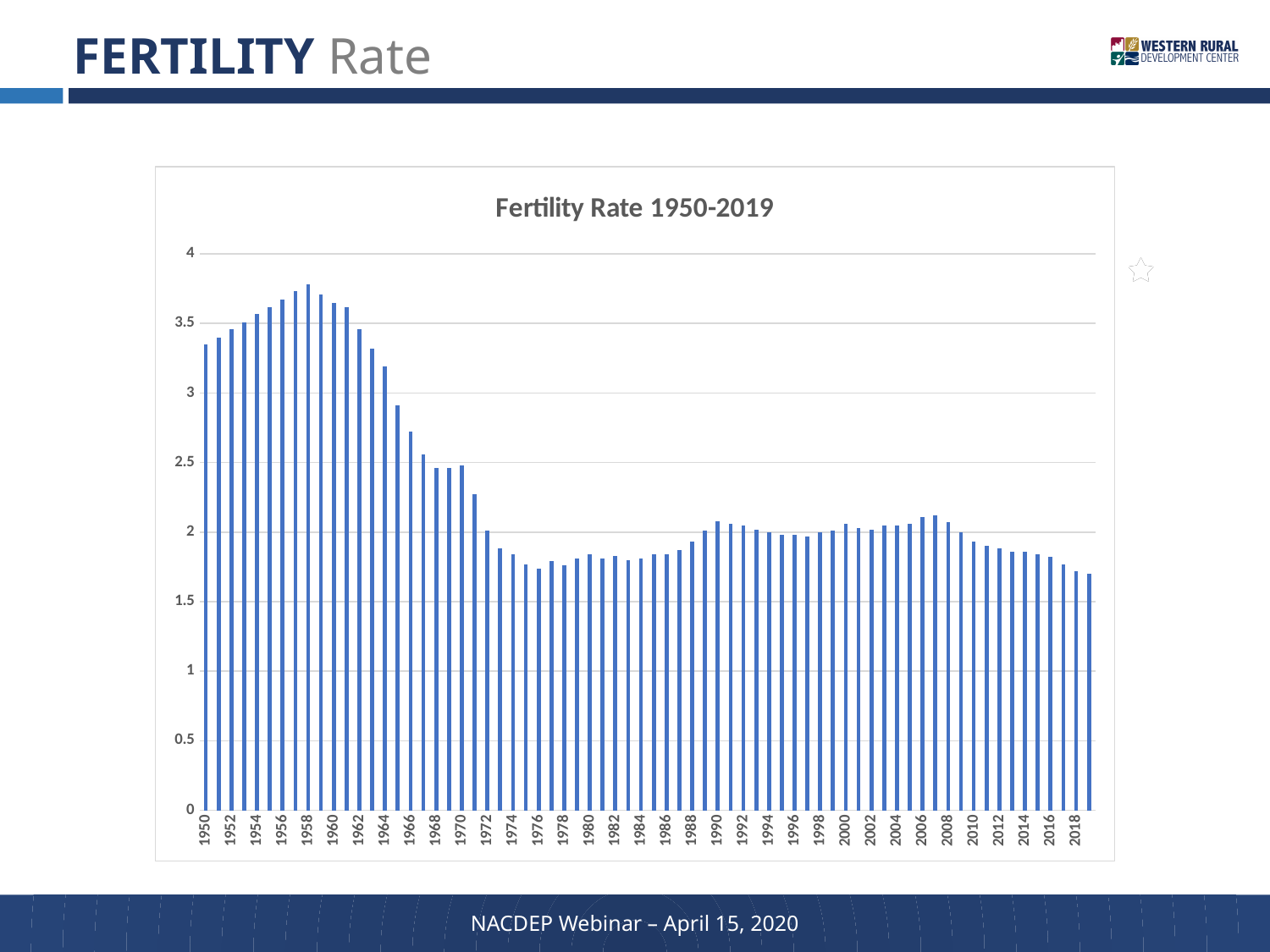
Is the fertility rate for 2018 greater or less than 2? less How many years (bars) are plotted in the chart? 70 Do the fertility rate values rise or fall from 1958 to 1976? Fall Which year has the higher fertility rate, 1976 or 1990? 1990 Is the fertility rate for 1960 greater or less than 3.5? greater Is the fertility rate for 1966 greater or less than 3? less What kind of chart is shown on the slide? Bar chart Which year has the higher fertility rate, 1958 or 1970? 1958 What is the highest value shown on the vertical axis? 4 What is the title of the chart? Fertility Rate 1950-2019